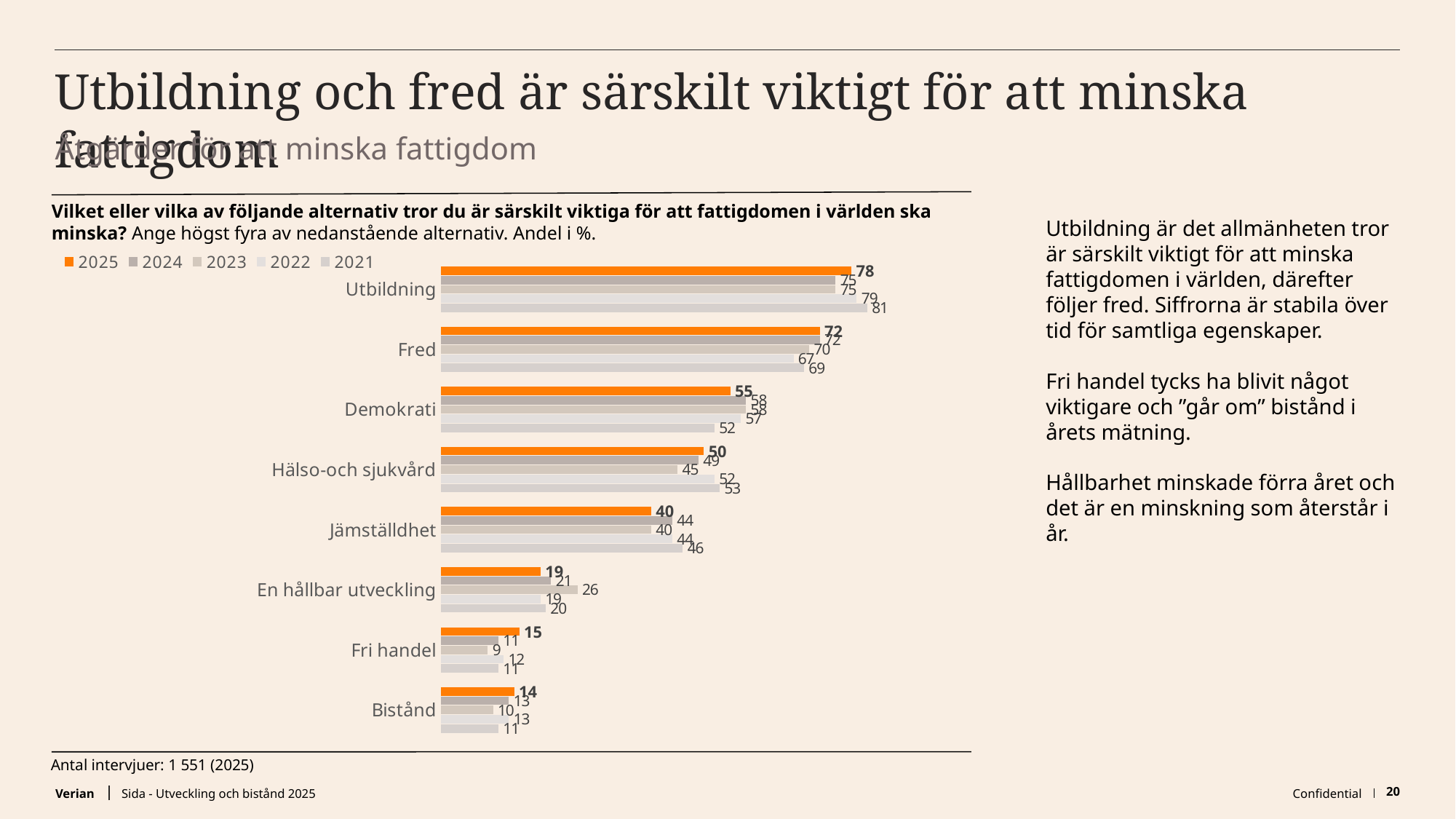
What is the 2025 value for Fred? 72 Which colour represents the 2025 series in the chart? Orange Which category has the highest 2025 value? Utbildning How many series does the legend list? 5 What is the difference between the 2025 values for Utbildning and Fred? 6 What is the 2025 value for Utbildning? 78 What is the 2023 value for En hållbar utveckling? 26 Which category has the lowest 2025 value? Bistånd What is the 2025 value for Bistånd? 14 Which has the larger 2025 value, Demokrati or Hälso-och sjukvård? Demokrati How many categories are shown in the chart? 8 What kind of chart is shown on the slide? Bar chart